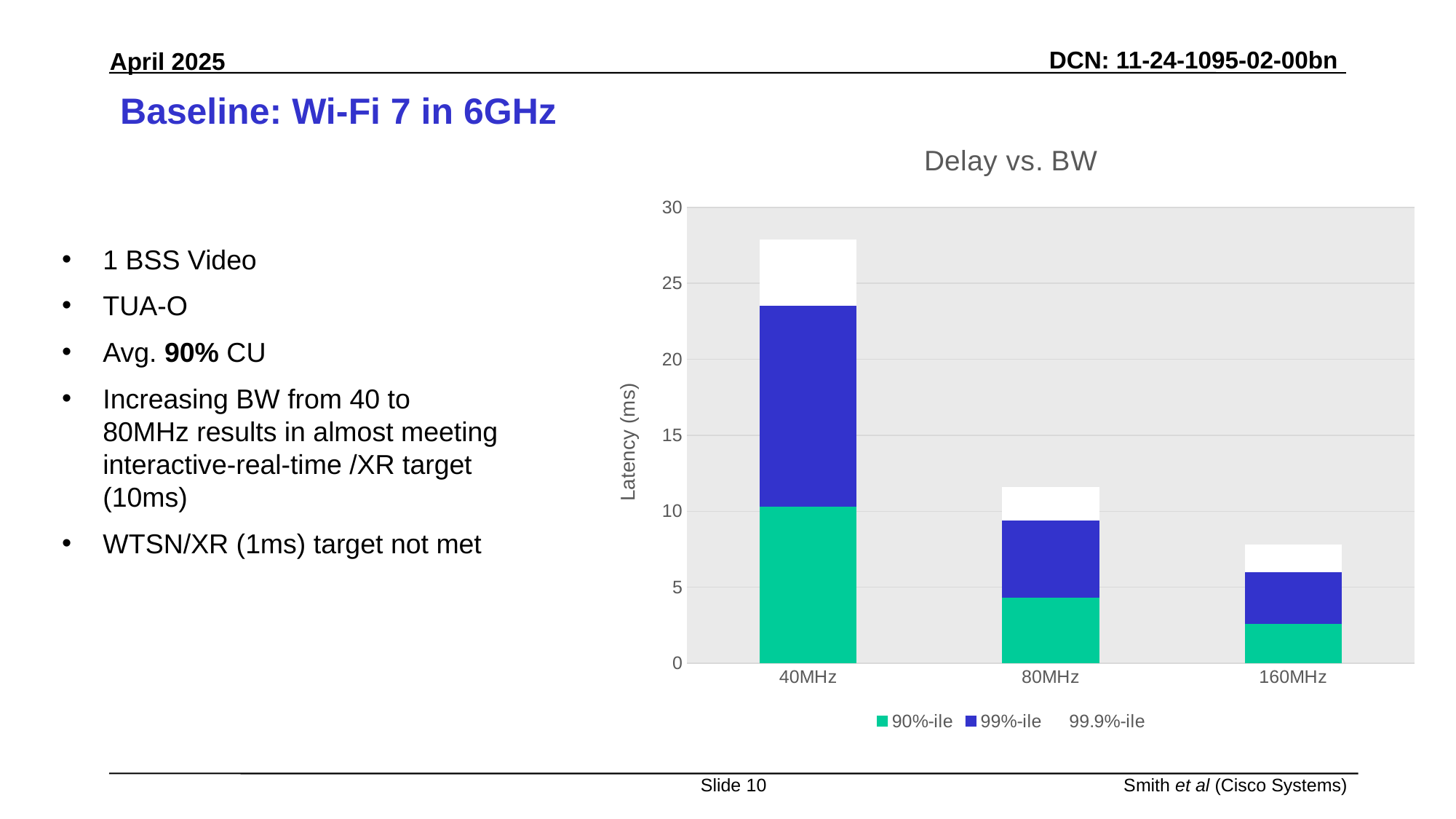
Which bandwidth has the highest total latency bar? 40MHz Which bandwidth has the lowest total latency bar? 160MHz How many bandwidth categories are shown on the x axis? 3 Is the 90%-ile value for 160MHz greater or less than 5? less Is the total height of the 40MHz bar greater or less than 25? greater What is the title of the chart? Delay vs. BW Which is larger, the 90%-ile latency at 40MHz or at 80MHz? 40MHz What is the label of the y axis? Latency (ms) How many series does the chart legend list? 3 Does latency rise or fall as bandwidth increases from 40MHz to 160MHz? fall Is the total height of the 80MHz bar greater or less than 15? less What kind of chart is shown on the slide? stacked bar chart